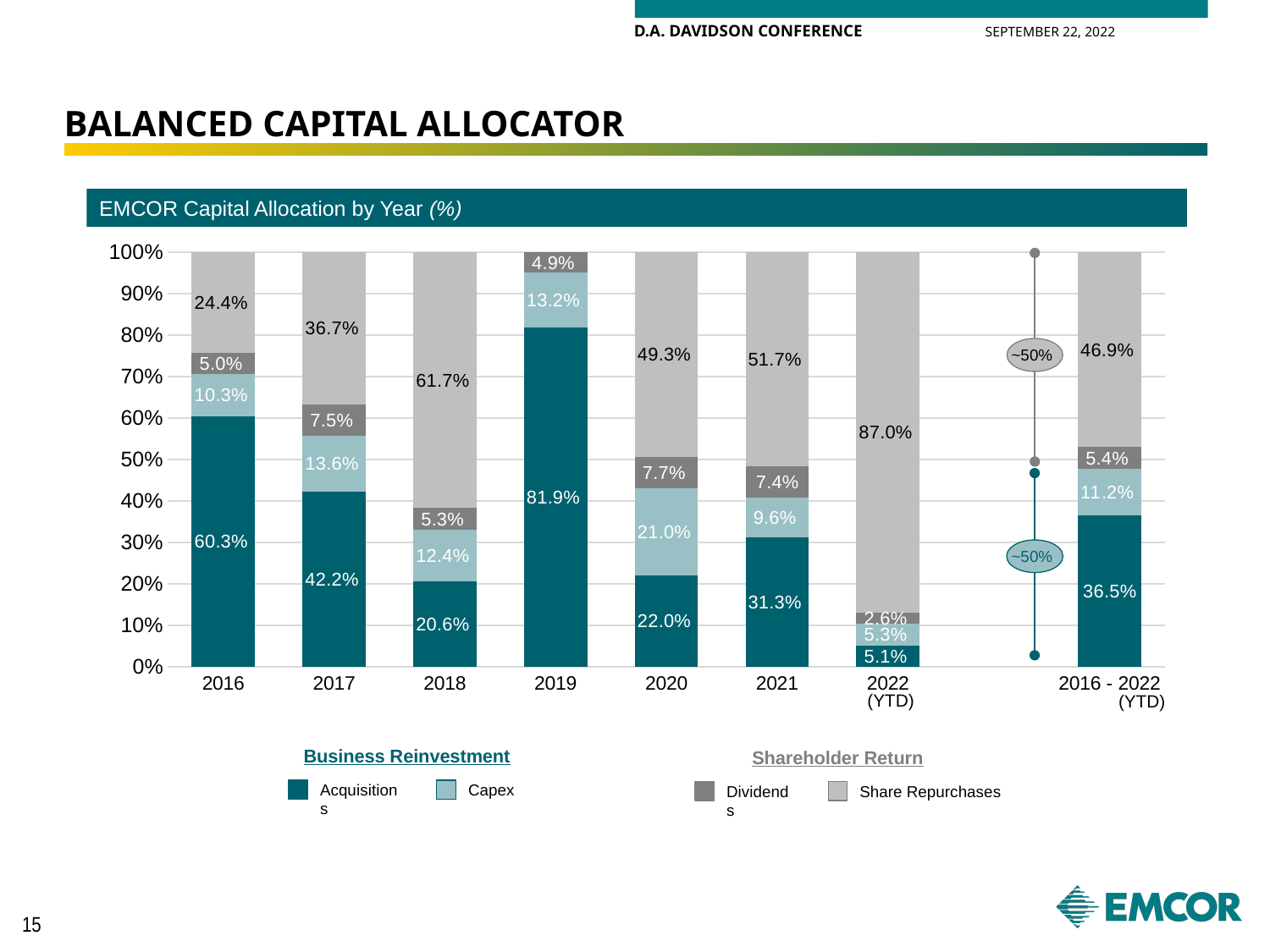
Which is larger, the Capex share in 2017 or in 2021? 2017 What is the Acquisitions share for 2019? 81.9% What is the difference between the Share Repurchases share in 2018 and in 2017? 25.0% What is the Capex share for 2020? 21.0% What is the Dividends share for 2016 - 2022 (YTD)? 5.4% What kind of chart is shown on the slide? Stacked bar chart How many year categories are shown on the x axis? 8 Which year has the lowest Acquisitions share? 2022 (YTD) What is the Share Repurchases share for 2022 (YTD)? 87.0% How many series does the legend list? 4 Which year has the highest Acquisitions share? 2019 What is the title of the chart? EMCOR Capital Allocation by Year (%)